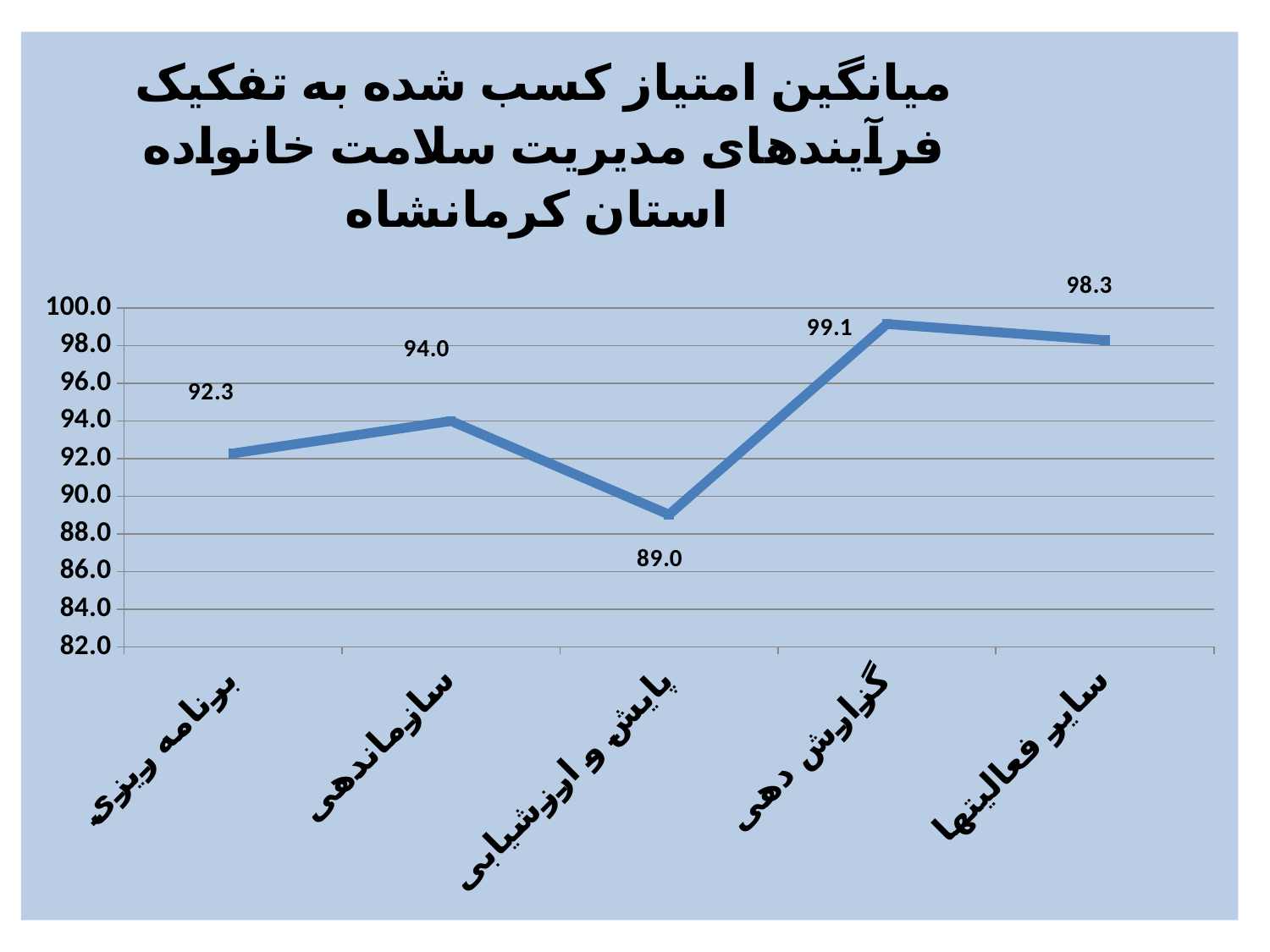
What is the value for سایر فعالیتها? 98.3 What is the difference between the values for گزارش دهی and پایش و ارزشیابی? 10.1 What is the value for پایش و ارزشیابی? 89.0 What is the value for گزارش دهی? 99.1 Which category has the highest value? گزارش دهی What is the value for سازماندهی? 94.0 Is the value for پایش و ارزشیابی greater or less than 90.0? less What kind of chart is shown on the slide? line chart How many categories are plotted on the chart? 5 Which category has the lowest value? پایش و ارزشیابی What is the value for برنامه ریزی? 92.3 Which is larger, the value for سازماندهی or the value for برنامه ریزی? سازماندهی